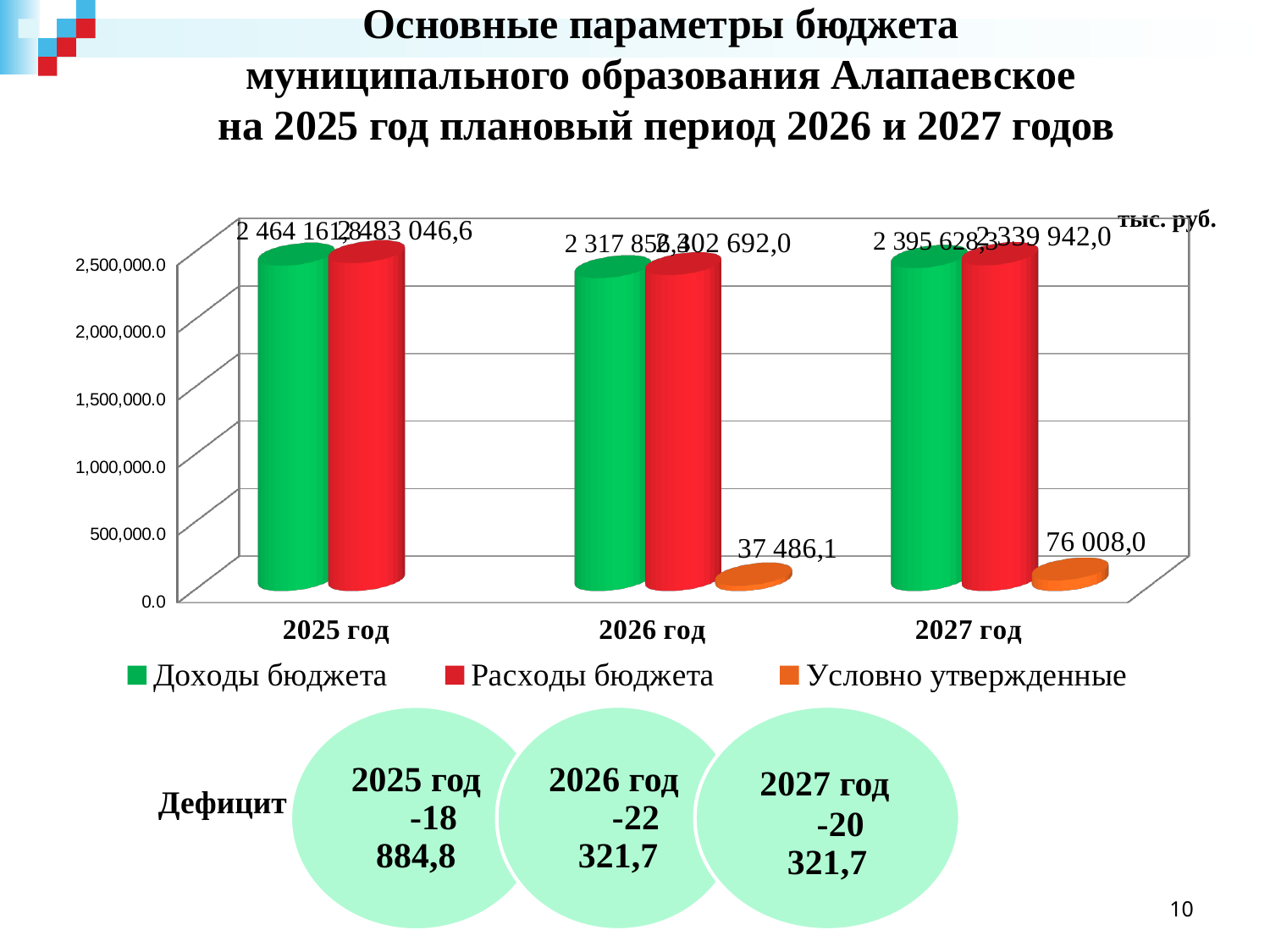
How many series does the chart legend list? 3 What type of chart is shown on the slide? bar chart Is the value of Расходы бюджета for 2026 год greater or less than 1,500,000.0? greater What is the value of Условно утвержденные for 2027 год? 76 008,0 Is the value of Условно утвержденные for 2027 год greater or less than 500,000.0? less Which year has the higher value for Условно утвержденные, 2026 год or 2027 год? 2027 год Which series is shown in orange in the chart legend? Условно утвержденные How many year categories are shown on the x axis of the chart? 3 What unit is indicated at the top right of the chart? тыс. руб. Is the value of Доходы бюджета for 2025 год greater or less than 2,000,000.0? greater What is the value of Условно утвержденные for 2026 год? 37 486,1 What is the difference between the Условно утвержденные values for 2027 год and 2026 год? 38 521,9